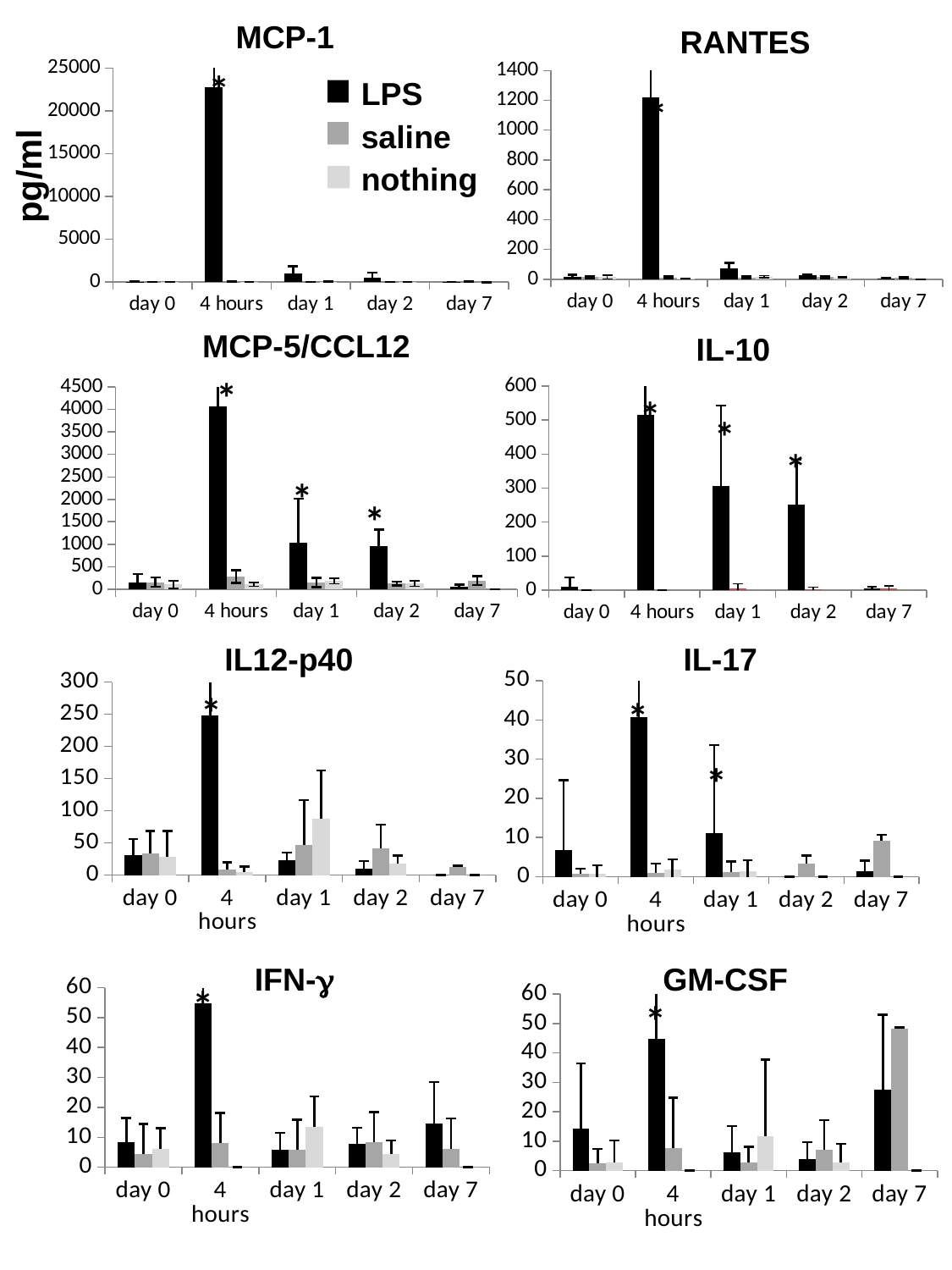
What kind of chart is the MCP-1 chart? bar chart In the IL-17 chart, is the LPS value at 4 hours greater or less than 30? greater How many series does the legend on the MCP-1 chart list? 3 In the RANTES chart, is the LPS value at 4 hours greater or less than 1000? greater In the IL-10 chart, which is larger: the LPS value at day 1 or the LPS value at day 2? day 1 In the GM-CSF chart, which series has the highest value at day 7? saline What is the y-axis label shown on the MCP-1 chart? pg/ml In the MCP-1 chart, is the LPS value at 4 hours greater or less than 20000? greater How many time points are shown on the x axis of the RANTES chart? 5 In the MCP-1 chart, at which time point is the LPS value highest? 4 hours In the IL12-p40 chart, which series has the highest value at day 1? nothing